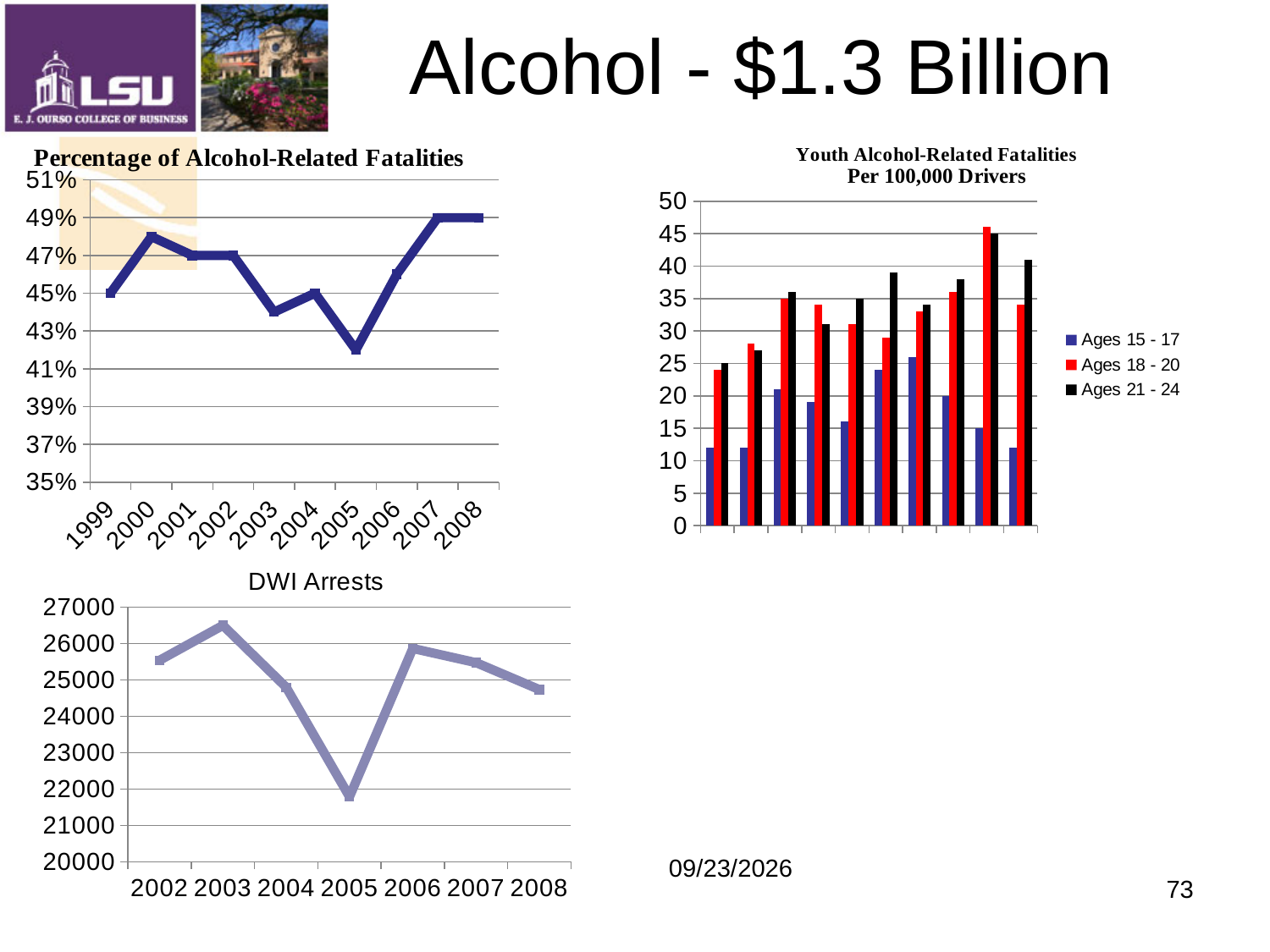
On the 'Percentage of Alcohol-Related Fatalities' chart, is the value for 2005 greater or less than 43%? less On the 'Percentage of Alcohol-Related Fatalities' chart, what is the value for 1999? 45% On the 'Percentage of Alcohol-Related Fatalities' chart, which year has the lowest value? 2005 On the 'Percentage of Alcohol-Related Fatalities' chart, what is the value for 2007? 49% On the 'DWI Arrests' chart, which year has the highest value? 2003 On the 'DWI Arrests' chart, is the value for 2005 greater or less than 23000? less On the 'Youth Alcohol-Related Fatalities Per 100,000 Drivers' chart, which series is shown in red? Ages 18 - 20 What kind of chart is the 'Youth Alcohol-Related Fatalities Per 100,000 Drivers' chart? bar chart How many years are plotted on the 'Percentage of Alcohol-Related Fatalities' chart? 10 On the 'Percentage of Alcohol-Related Fatalities' chart, which year has the larger value, 2000 or 2003? 2000 On the 'DWI Arrests' chart, which year has the lowest value? 2005 How many series does the legend of the 'Youth Alcohol-Related Fatalities Per 100,000 Drivers' chart list? 3